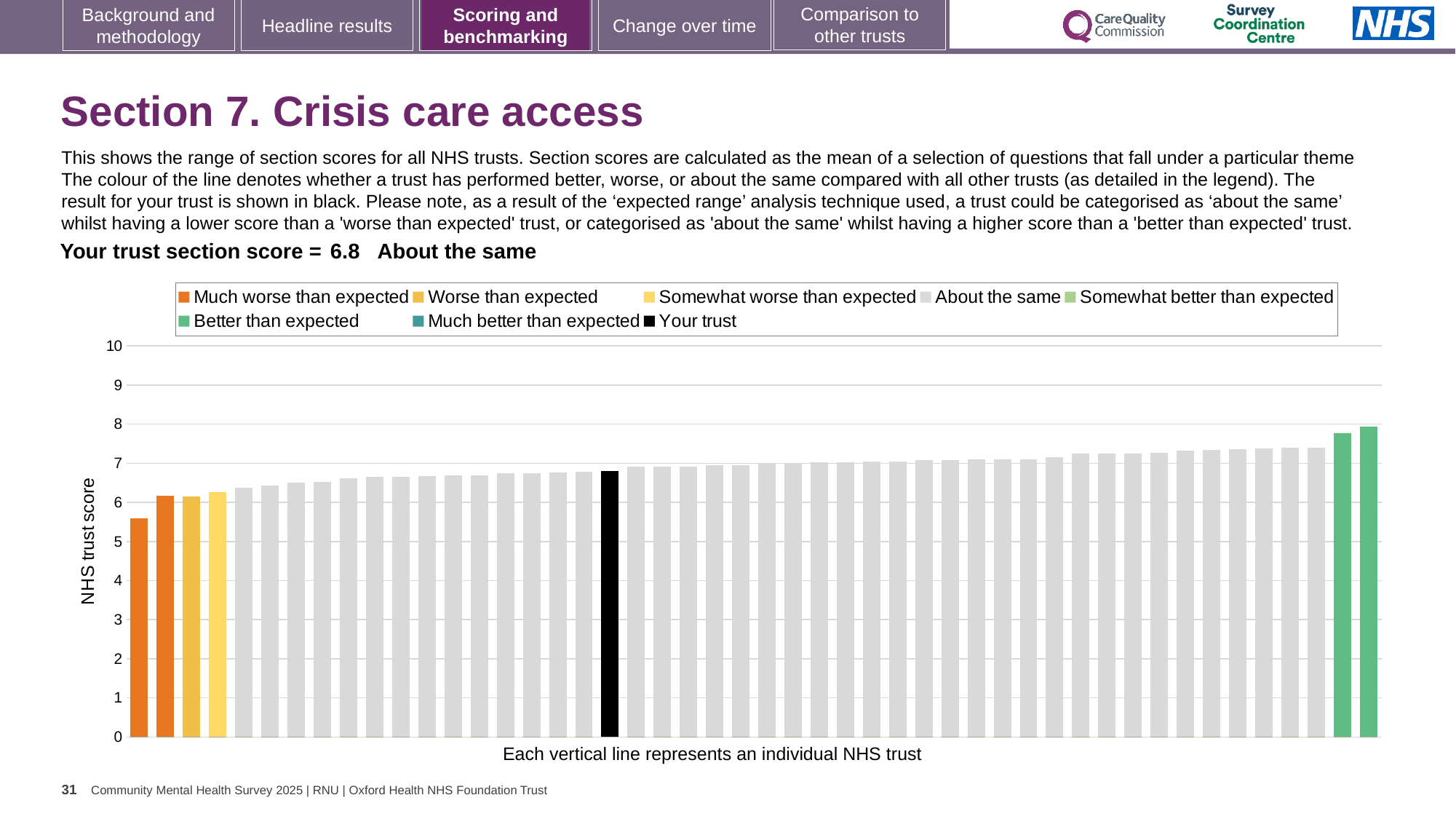
Is the value of the leftmost (lowest) bar greater or less than 6? less How many entries does the chart legend list? 8 Do the bar values rise or fall from left to right along the x axis? rise Which is larger: the black 'Your trust' bar or the leftmost orange bar? the black 'Your trust' bar What is the section score for your trust shown on the slide? 6.8 How many bars are coloured green ('Better than expected')? 2 What is the label on the vertical axis of the chart? NHS trust score Which legend category does the highest bar on the chart belong to? Better than expected How many bars are coloured orange ('Much worse than expected')? 2 Is the value of the black 'Your trust' bar greater or less than 6? greater What kind of chart is shown on the slide? bar chart